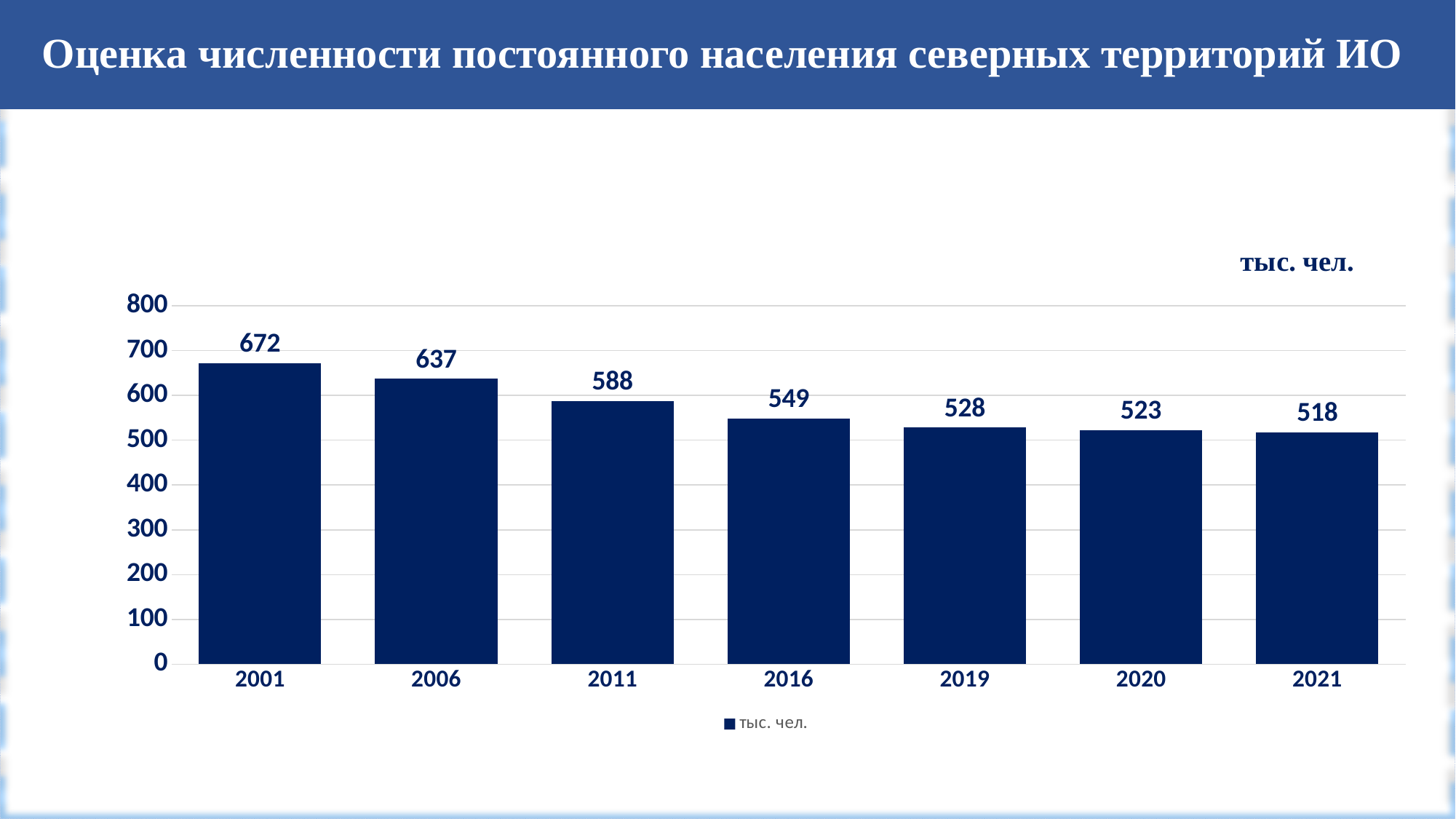
Which is larger, the value for 2011 or the value for 2019? 2011 What kind of chart is shown on the slide? bar chart What is the value for 2016? 549 What is the value for 2021? 518 Is the value for 2006 greater or less than 600? greater What is the difference between the values for 2006 and 2011? 49 Which year has the highest value? 2001 What is the value for 2001? 672 Do the values rise or fall from 2001 to 2021? fall Which year has the lowest value? 2021 How many years are shown on the x axis? 7 What is the difference between the values for 2001 and 2021? 154